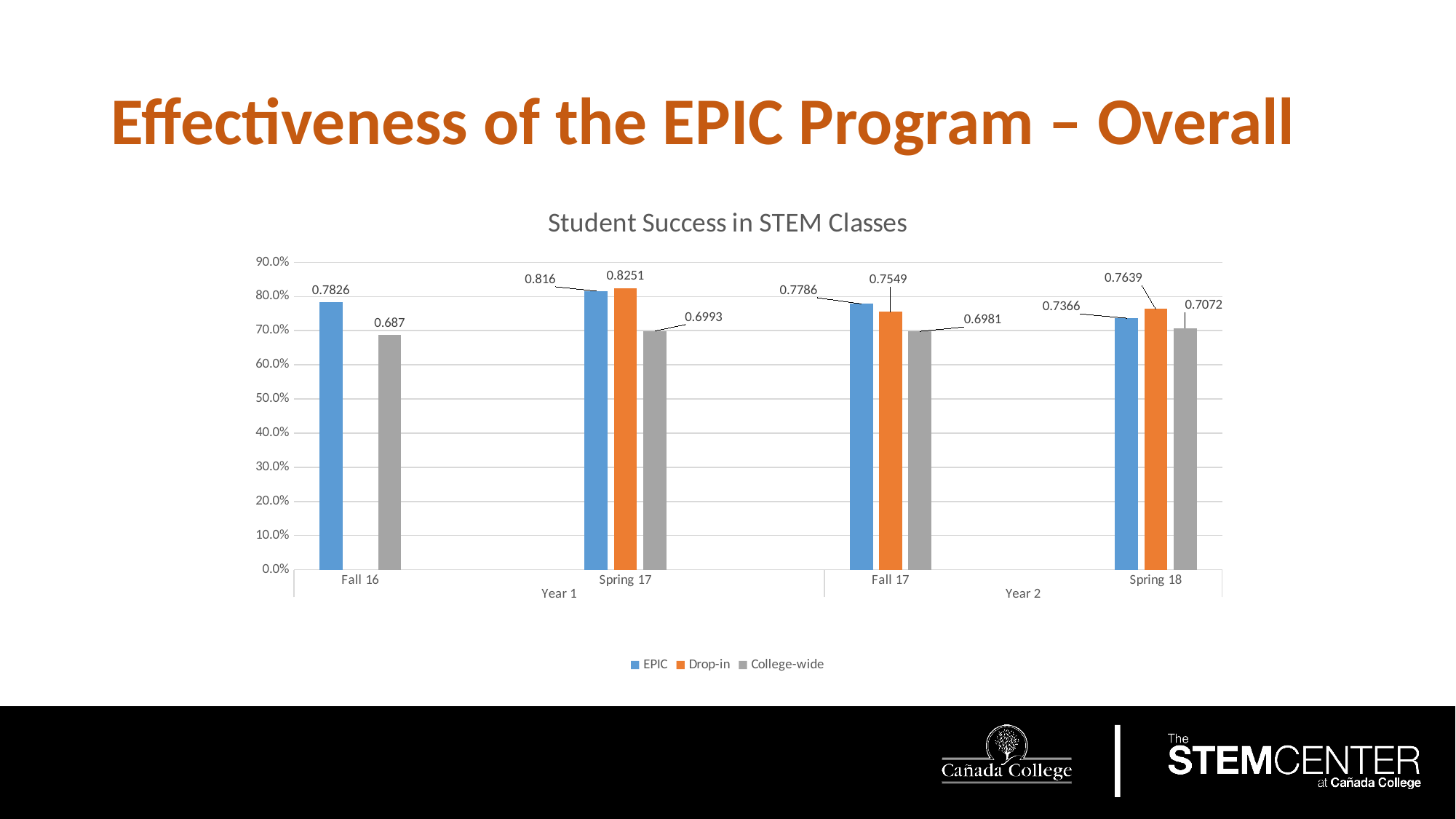
Which is larger in Spring 18, the EPIC value or the Drop-in value? Drop-in What is the difference between the EPIC and College-wide values for Fall 16? 0.0956 Which semester has the highest Drop-in value? Spring 17 What is the title of the chart? Student Success in STEM Classes Which semester has the lowest College-wide value? Fall 16 What is the Drop-in value for Fall 17? 0.7549 How many series does the legend list? 3 What is the Drop-in value for Spring 18? 0.7639 What kind of chart is shown? Bar chart How many semesters are shown on the x axis? 4 What is the EPIC value for Fall 16? 0.7826 What is the College-wide value for Spring 17? 0.6993